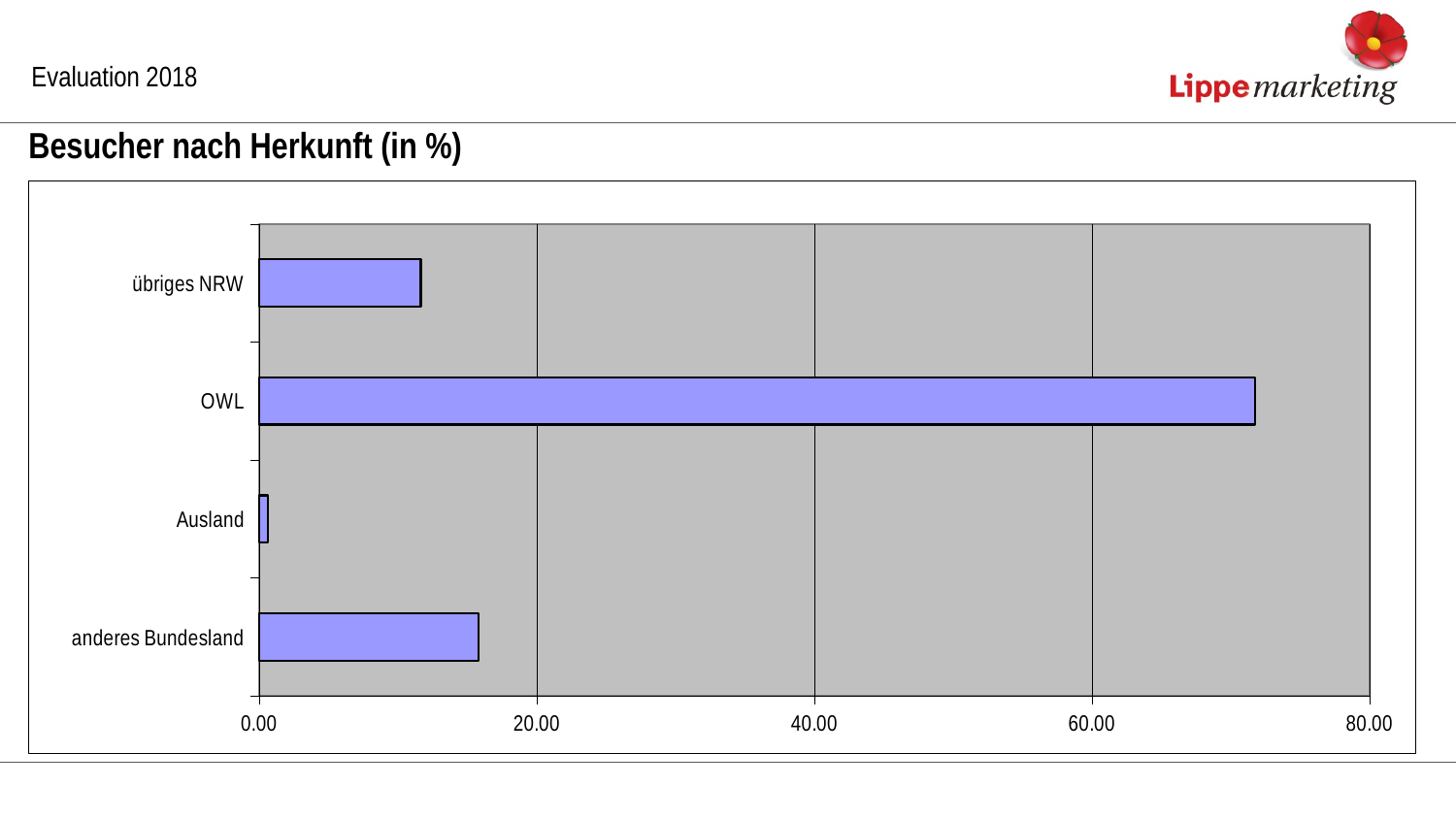
Which is larger, the value for OWL or the value for übriges NRW? OWL Which is larger, the value for übriges NRW or the value for anderes Bundesland? anderes Bundesland Is the value for OWL greater or less than 60.00? greater Which category has the highest value? OWL What kind of chart is shown on the slide? bar chart Which category has the lowest value? Ausland Is the value for OWL greater or less than 80.00? less How many categories are shown in the chart? 4 What is the highest value shown on the horizontal axis? 80.00 Is the value for anderes Bundesland greater or less than 20.00? less What is the title of the chart? Besucher nach Herkunft (in %)